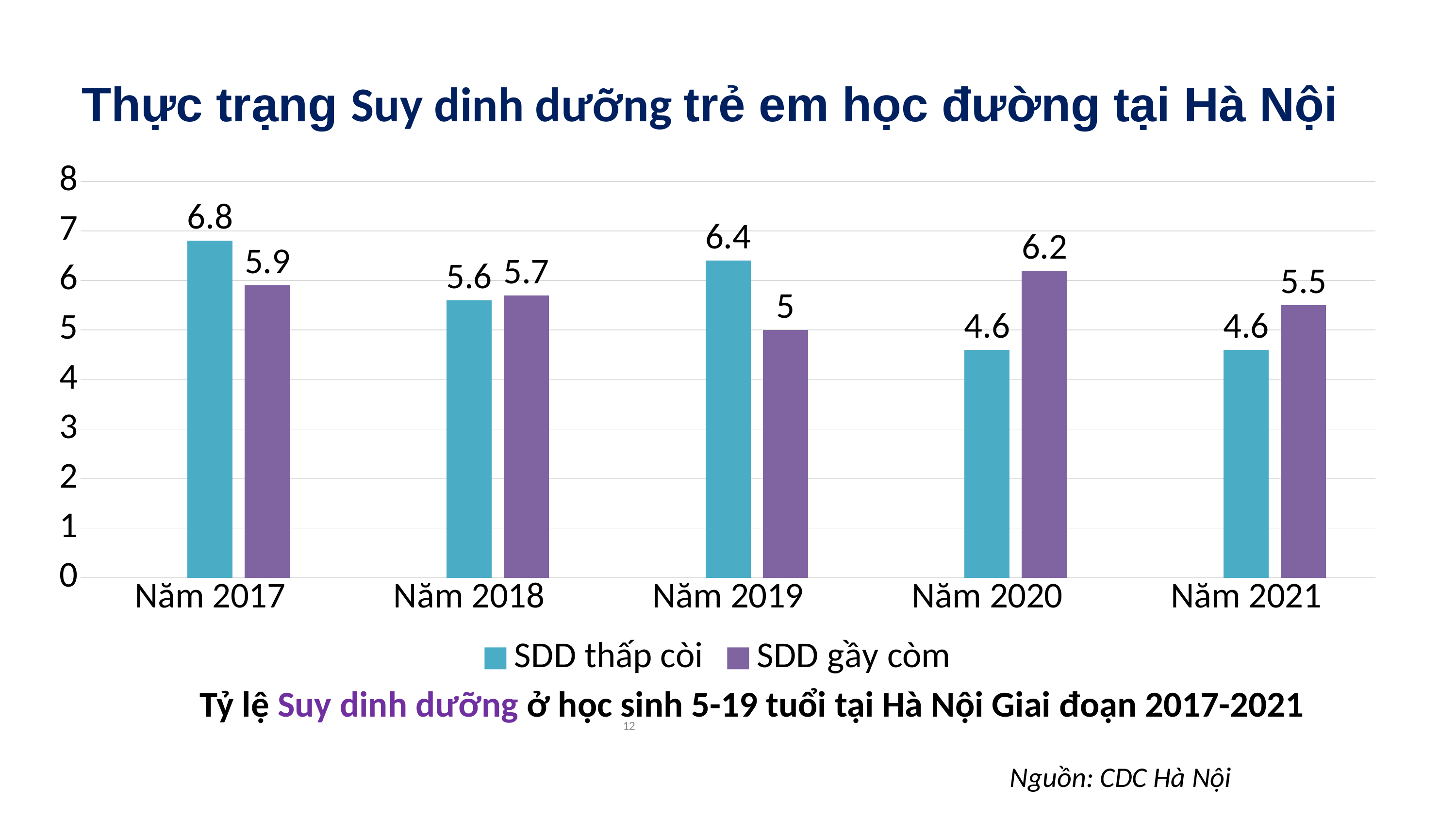
How many series does the legend list? 2 What is the value of SDD gầy còm for Năm 2020? 6.2 Which is larger in Năm 2019, SDD thấp còi or SDD gầy còm? SDD thấp còi Is the value of SDD thấp còi for Năm 2021 greater or less than 5? less How many years are shown on the x axis? 5 What is the difference between SDD thấp còi and SDD gầy còm in Năm 2020? 1.6 What is the value of SDD gầy còm for Năm 2019? 5 Which year has the lowest value for SDD gầy còm? Năm 2019 What is the value of SDD thấp còi for Năm 2017? 6.8 Which year has the highest value for SDD thấp còi? Năm 2017 Does SDD thấp còi generally rise or fall from Năm 2017 to Năm 2021? fall What kind of chart is shown on the slide? bar chart